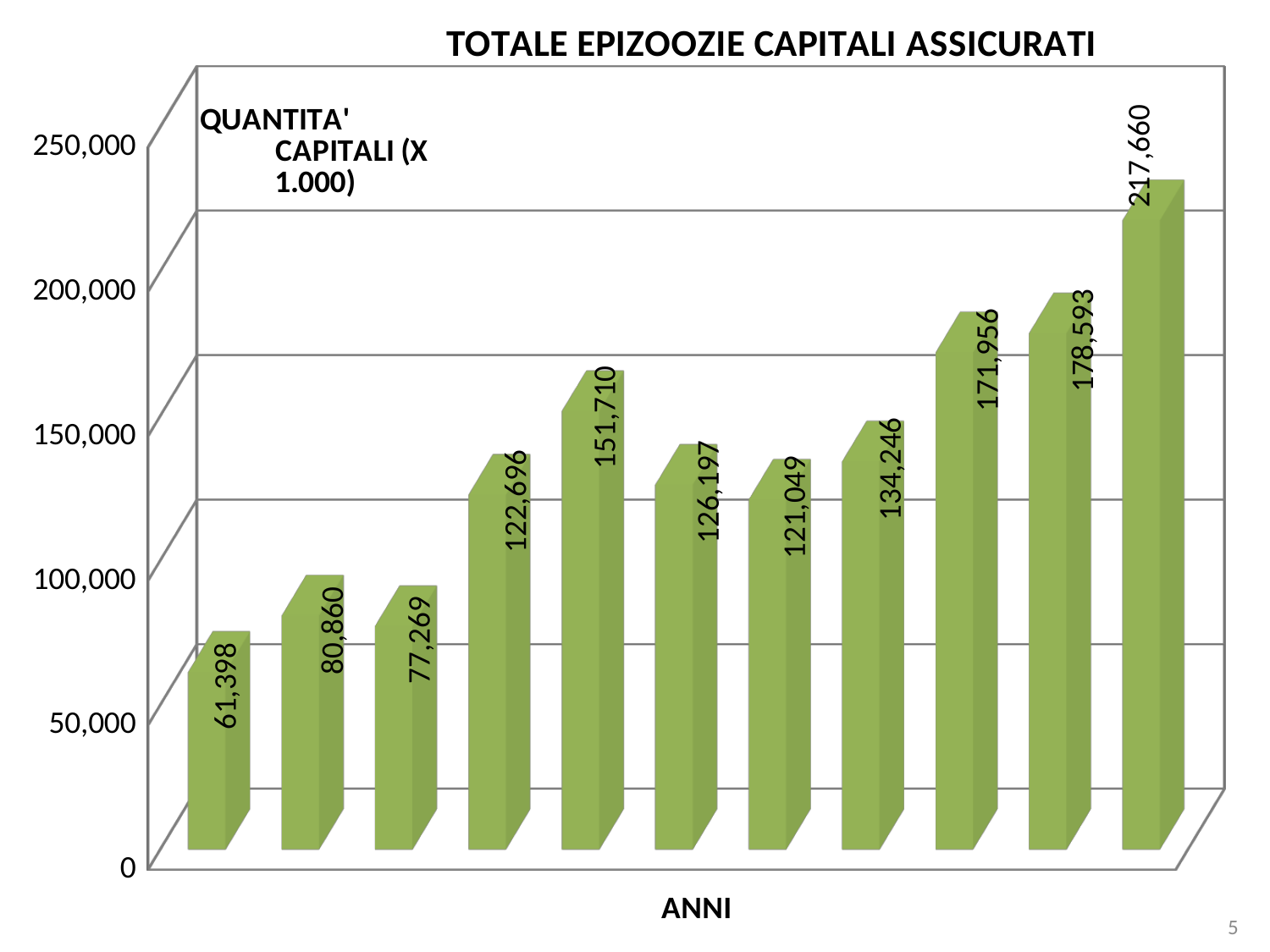
What is the difference between the rightmost bar (217,660) and the leftmost bar (61,398)? 156,262 What is the value of the first (leftmost) bar? 61,398 Which is larger, the second bar from the left or the third bar from the left? the second bar (80,860) What is the label of the horizontal axis? ANNI What is the highest value shown in the chart? 217,660 What is the value of the fifth bar from the left? 151,710 What is the lowest value shown in the chart? 61,398 How many bars are plotted in the chart? 11 What is the value of the last (rightmost) bar? 217,660 What kind of chart is shown on the slide? bar chart What is the title of the chart? TOTALE EPIZOOZIE CAPITALI ASSICURATI Do the values generally rise or fall from left to right across the chart? rise